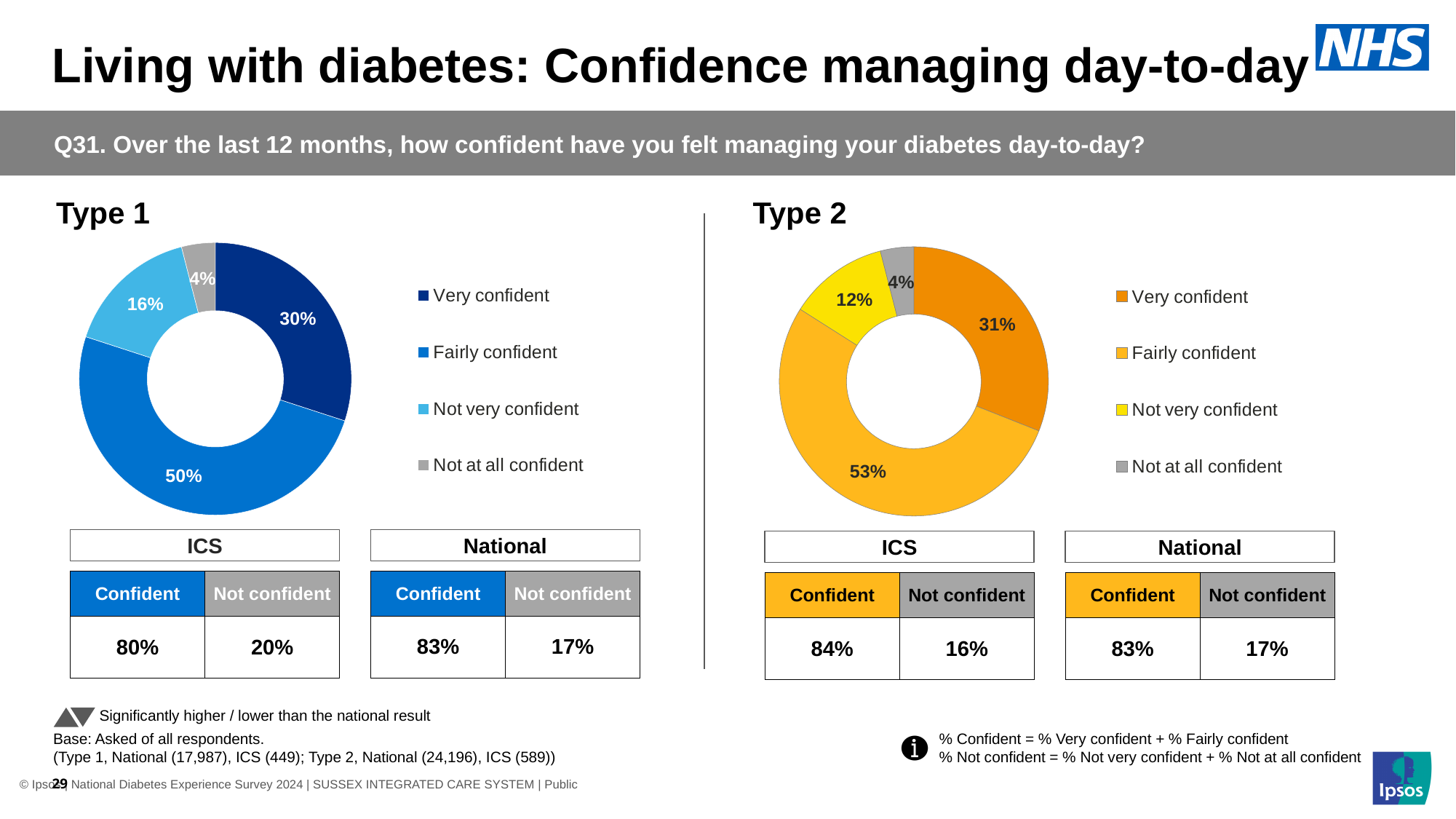
In the Type 1 chart, what percentage of respondents were Not very confident? 16% In the Type 2 chart, what is the combined share of Very confident and Fairly confident? 84% In the Type 1 chart, which category has the smallest share? Not at all confident In the Type 2 chart, what is the difference between the Not very confident and Not at all confident shares? 8 percentage points In the Type 2 chart, what percentage of respondents were Very confident? 31% In the Type 1 chart, what is the difference between the Fairly confident and Very confident shares? 20 percentage points In the Type 1 chart, what colour represents Very confident? Dark blue In the Type 1 chart, what percentage of respondents were Fairly confident? 50% How many categories does the Type 2 chart show? 4 In the Type 2 chart, which category has the largest share? Fairly confident What kind of chart is used for Type 1? Doughnut (pie) chart Is the Not very confident share larger in the Type 1 chart or the Type 2 chart? Type 1